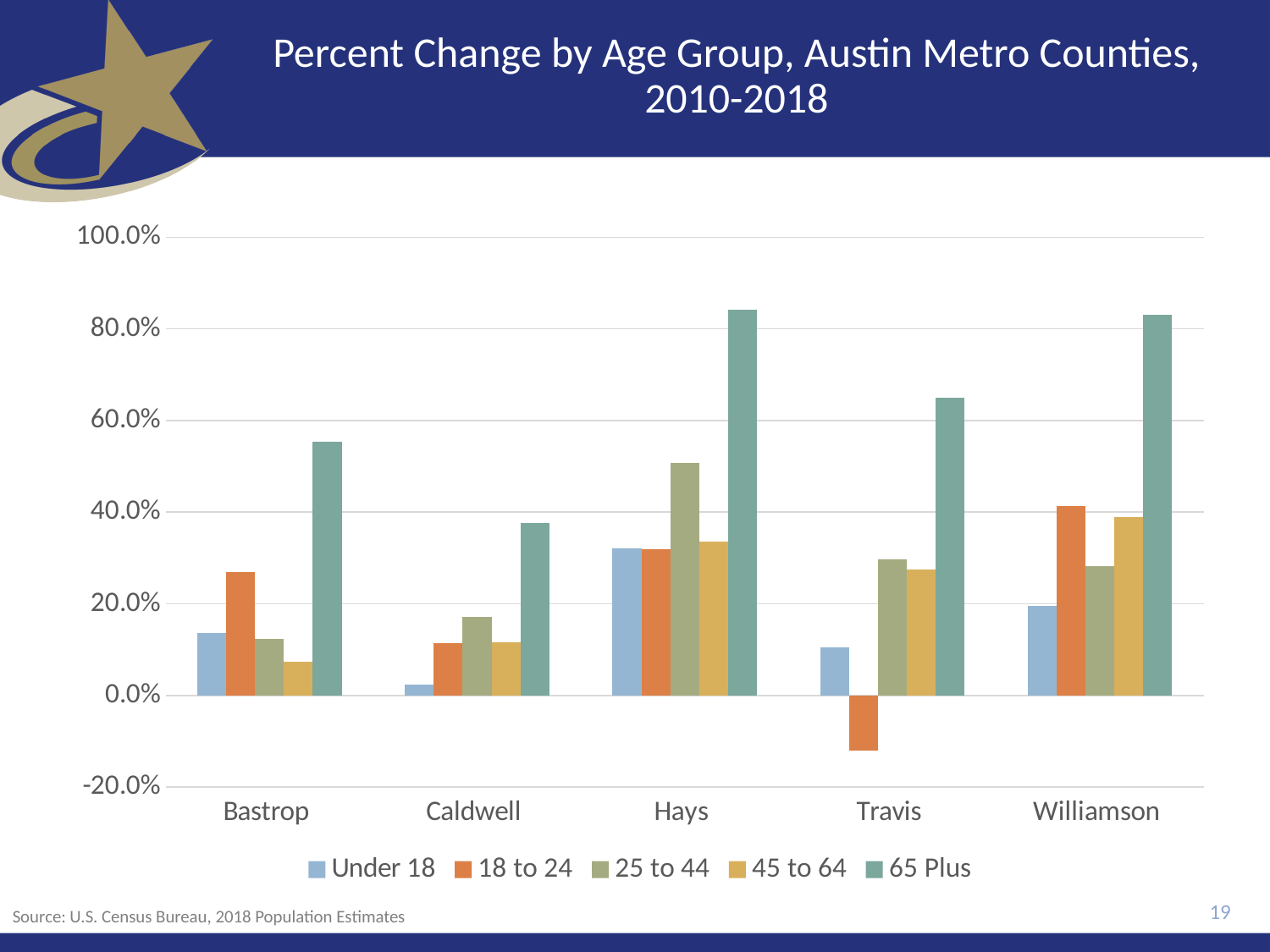
In Travis, which age group has the highest percent change? 65 Plus What kind of chart is shown on the slide? Bar chart In Williamson, which is larger: the value for 18 to 24 or the value for 25 to 44? 18 to 24 What is the title of the chart? Percent Change by Age Group, Austin Metro Counties, 2010-2018 Which county has the lowest value for 65 Plus? Caldwell Is the value for 65 Plus in Bastrop greater or less than 60.0%? less In Bastrop, which is larger: the value for Under 18 or the value for 18 to 24? 18 to 24 Which county has the lowest value for Under 18? Caldwell Is the value for 18 to 24 in Travis greater or less than 0.0%? less How many series does the legend list? 5 Is the value for 65 Plus in Hays greater or less than 80.0%? greater How many counties are shown on the x axis? 5